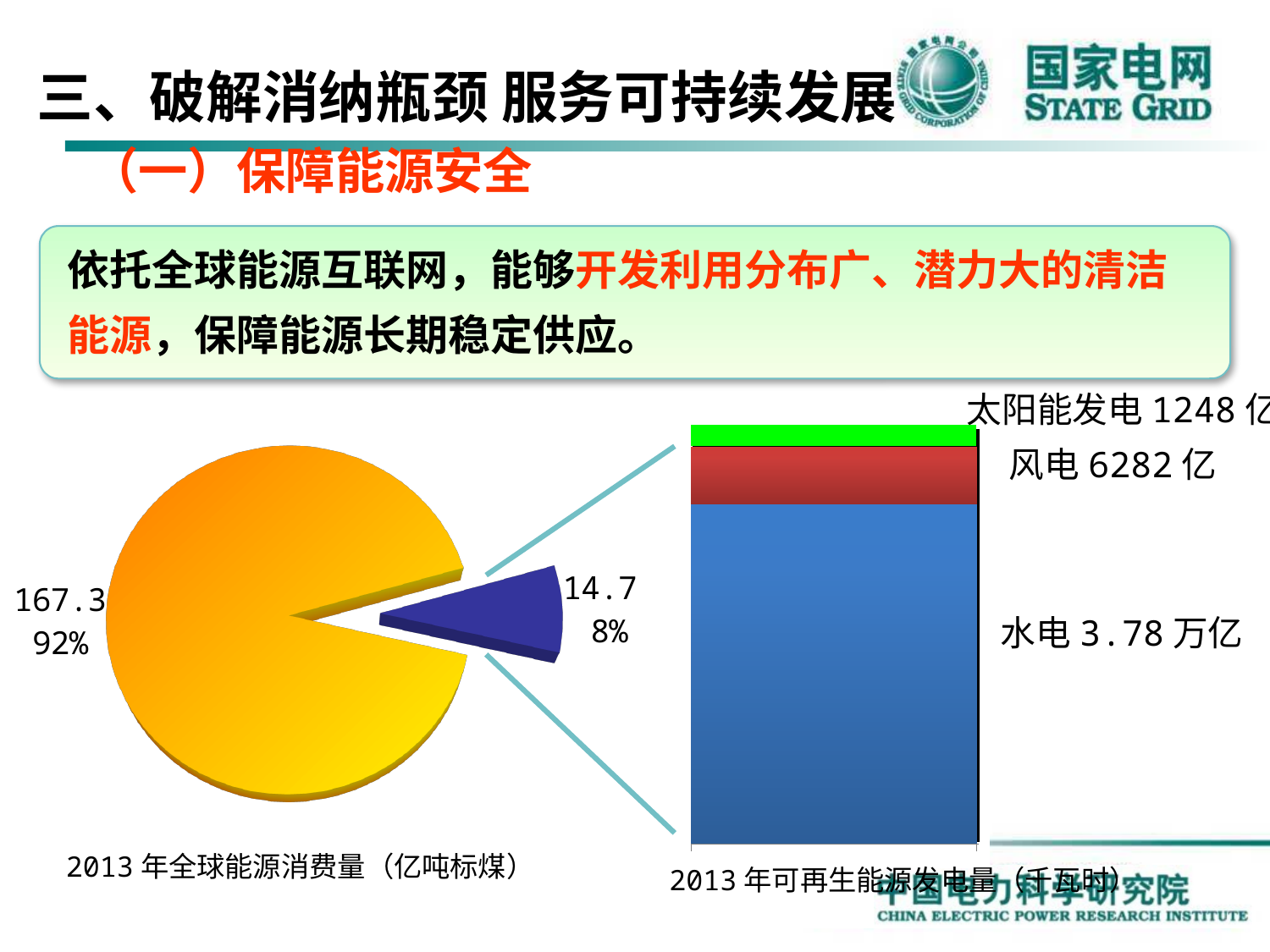
In the stacked bar chart on the right, what is the value for 太阳能发电? 1248 亿 In the pie chart on the left, what share of the pie does the yellow slice represent? 92% In the stacked bar chart on the right, which segment is the largest? 水电 In the pie chart on the left, what is the difference between the yellow slice value and the blue slice value? 152.6 In the stacked bar chart on the right, what is the value for 水电? 3.78 万亿 In the pie chart on the left, what value is shown for the large yellow slice? 167.3 In the pie chart on the left, how many slices are there? 2 In the stacked bar chart on the right, what is the value for 风电? 6282 亿 What kind of chart is the one on the right of the slide, titled 2013年可再生能源发电量（千瓦时）? stacked bar chart What kind of chart is the one on the left of the slide, titled 2013年全球能源消费量（亿吨标煤）? pie chart In the pie chart on the left, what share of the pie does the blue slice represent? 8% In the pie chart on the left, what value is shown for the small blue slice? 14.7